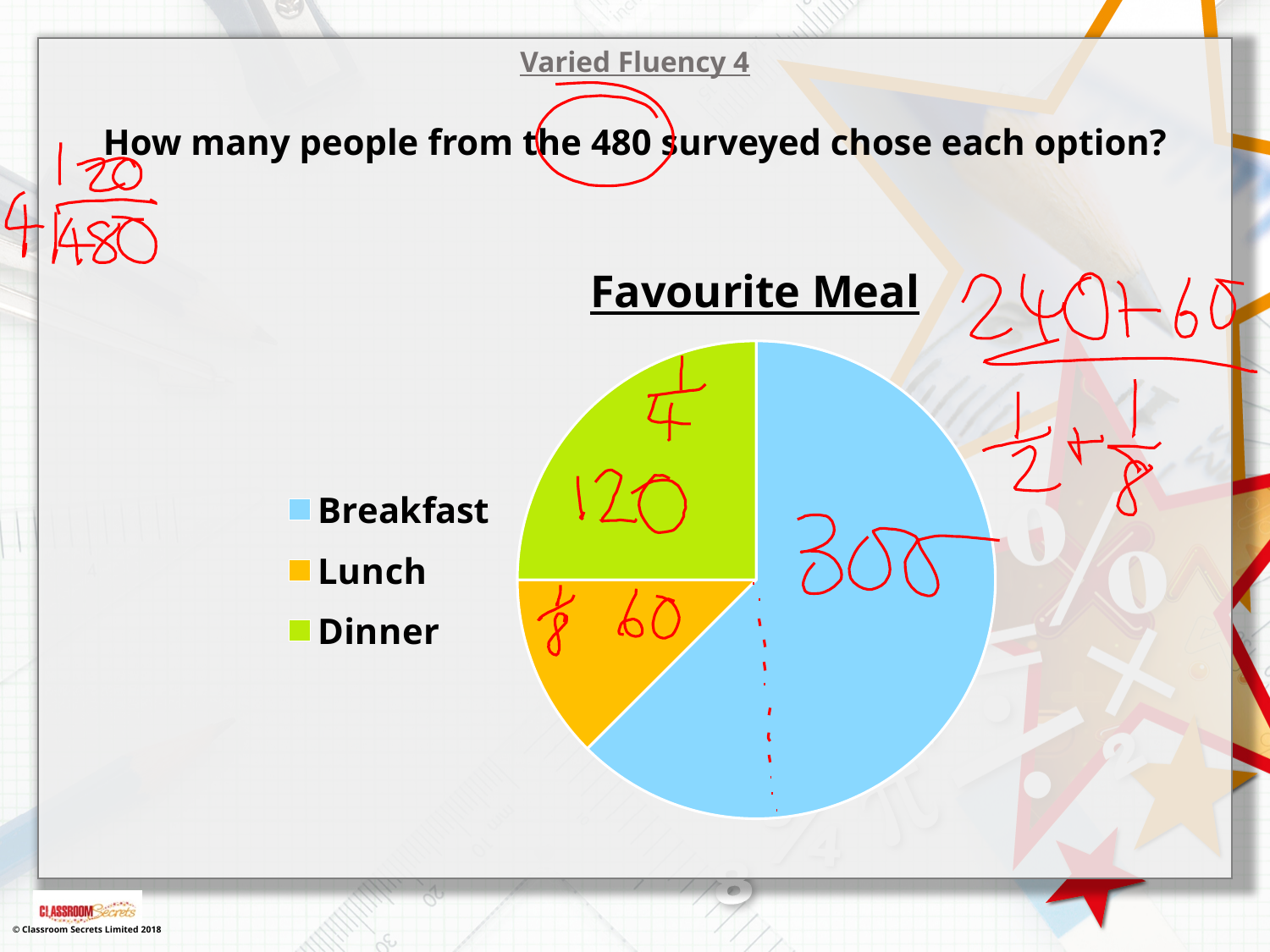
Which meal has the smallest slice of the pie chart? Lunch What kind of chart is shown on the slide? pie chart How many slices does the pie chart have? 3 Which slice is larger, Dinner or Lunch? Dinner Which meal has the largest slice of the pie chart? Breakfast Which colour represents Lunch in the pie chart? orange Does the Breakfast slice take up more or less than half of the pie chart? more Does the Lunch slice take up more or less than a quarter of the pie chart? less What is the title of the chart? Favourite Meal Which slice is larger, Breakfast or Dinner? Breakfast How many categories does the legend of the pie chart list? 3